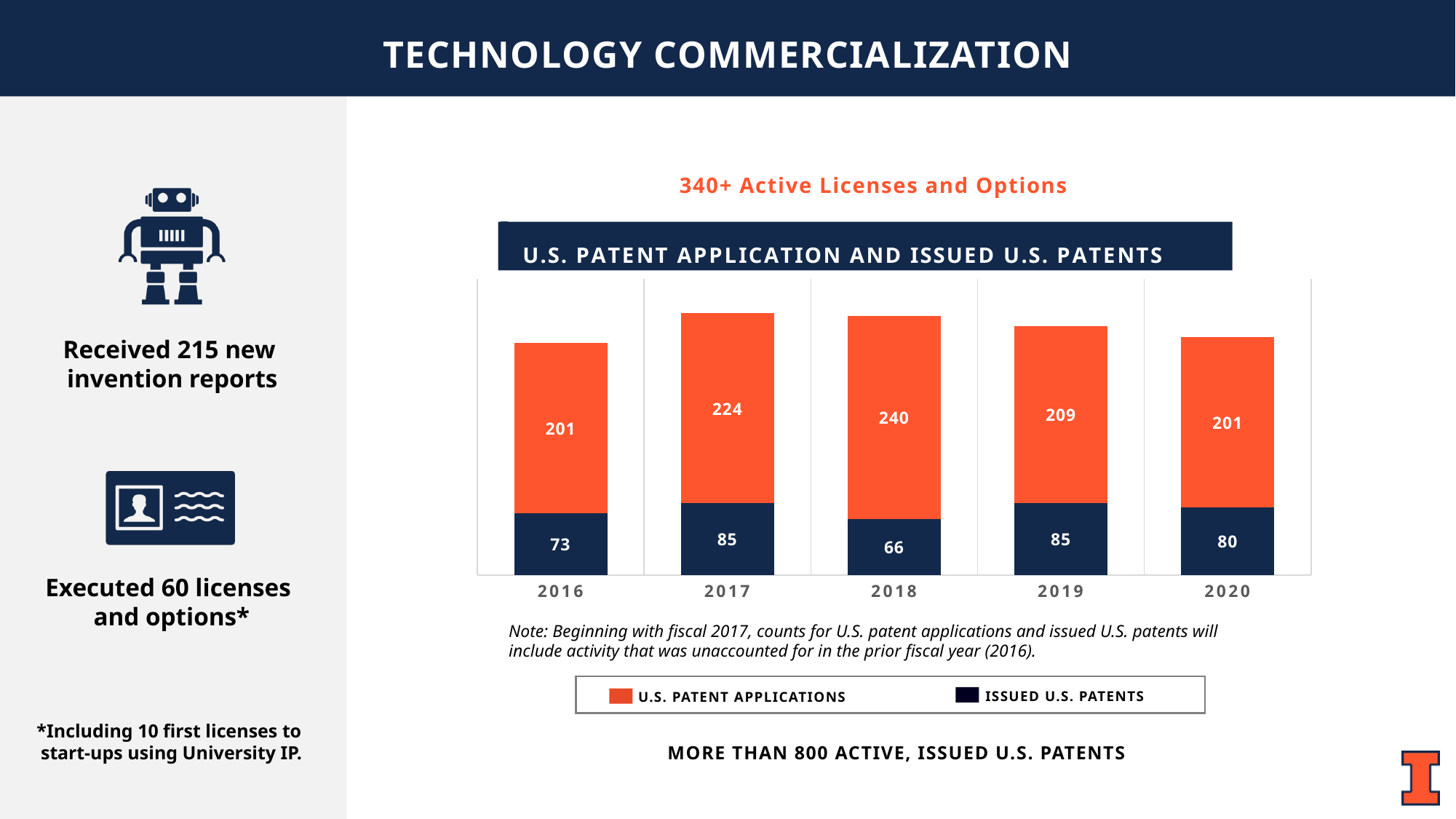
How many series does the legend list? 2 Which is larger, Issued U.S. Patents in 2019 or in 2020? 2019 What is the value for Issued U.S. Patents in 2016? 73 Which year has the lowest value for Issued U.S. Patents? 2018 What kind of chart is shown? Stacked bar chart What is the title of the chart? U.S. Patent Application and Issued U.S. Patents What is the value for U.S. Patent Applications in 2018? 240 What is the difference between U.S. Patent Applications in 2017 and 2020? 23 What is the total of the stacked bar for 2017? 309 How many years are shown on the x axis? 5 What is the total of the stacked bar for 2020? 281 Which year has the highest value for U.S. Patent Applications? 2018